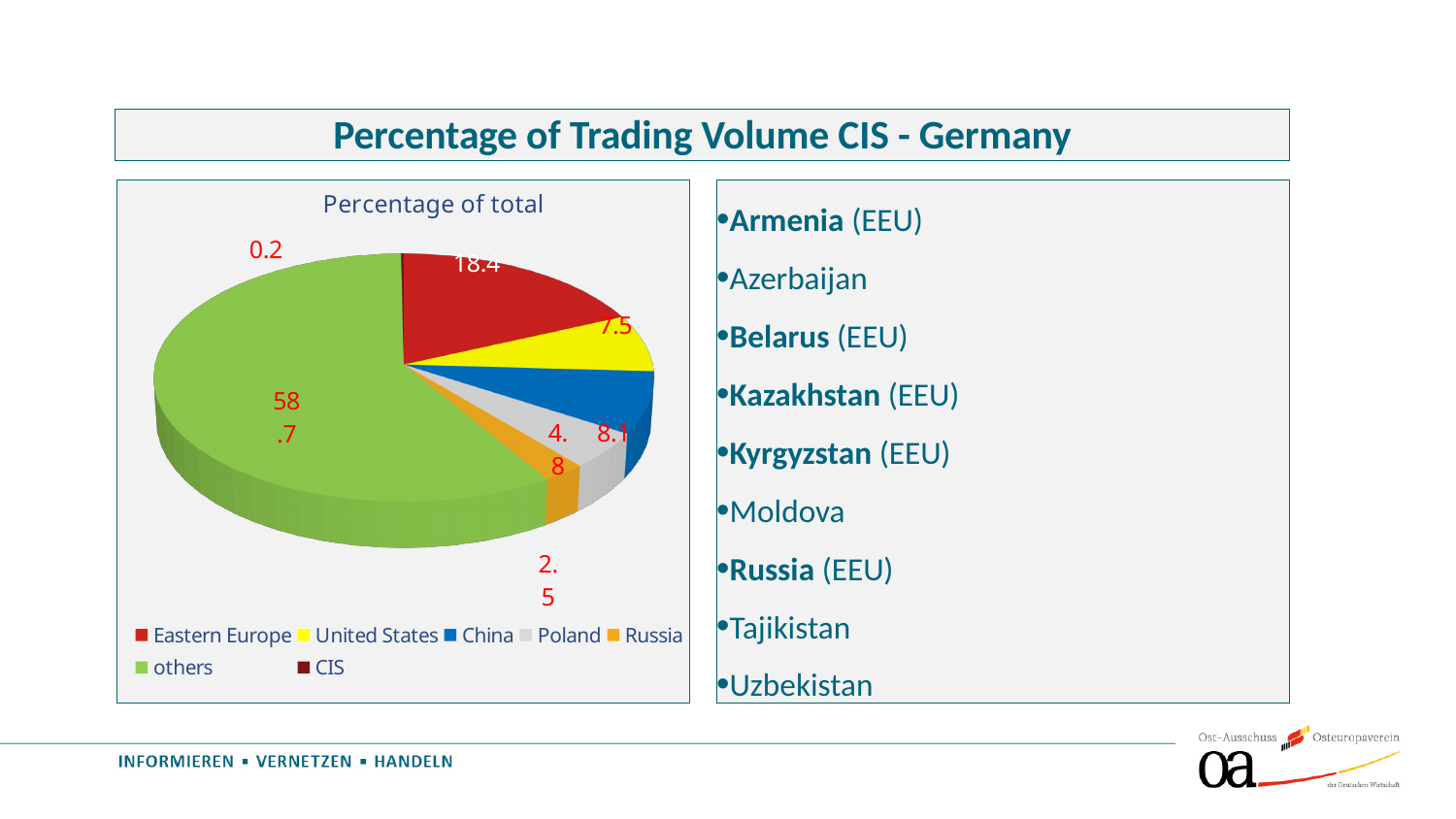
What is the value shown for Eastern Europe in the pie chart? 18.4 Which is larger in the pie chart, China or United States? China What kind of chart is shown on the slide? pie chart Which category has the largest slice of the pie chart? others What is the difference between the values for Eastern Europe and China? 10.3 What is the value shown for United States in the pie chart? 7.5 How many categories does the chart's legend list? 7 What is the value shown for China in the pie chart? 8.1 What colour represents others in the pie chart? green What is the difference between the values for others and Eastern Europe? 40.3 What is the value shown for others in the pie chart? 58.7 What is the title of the chart on the slide? Percentage of total